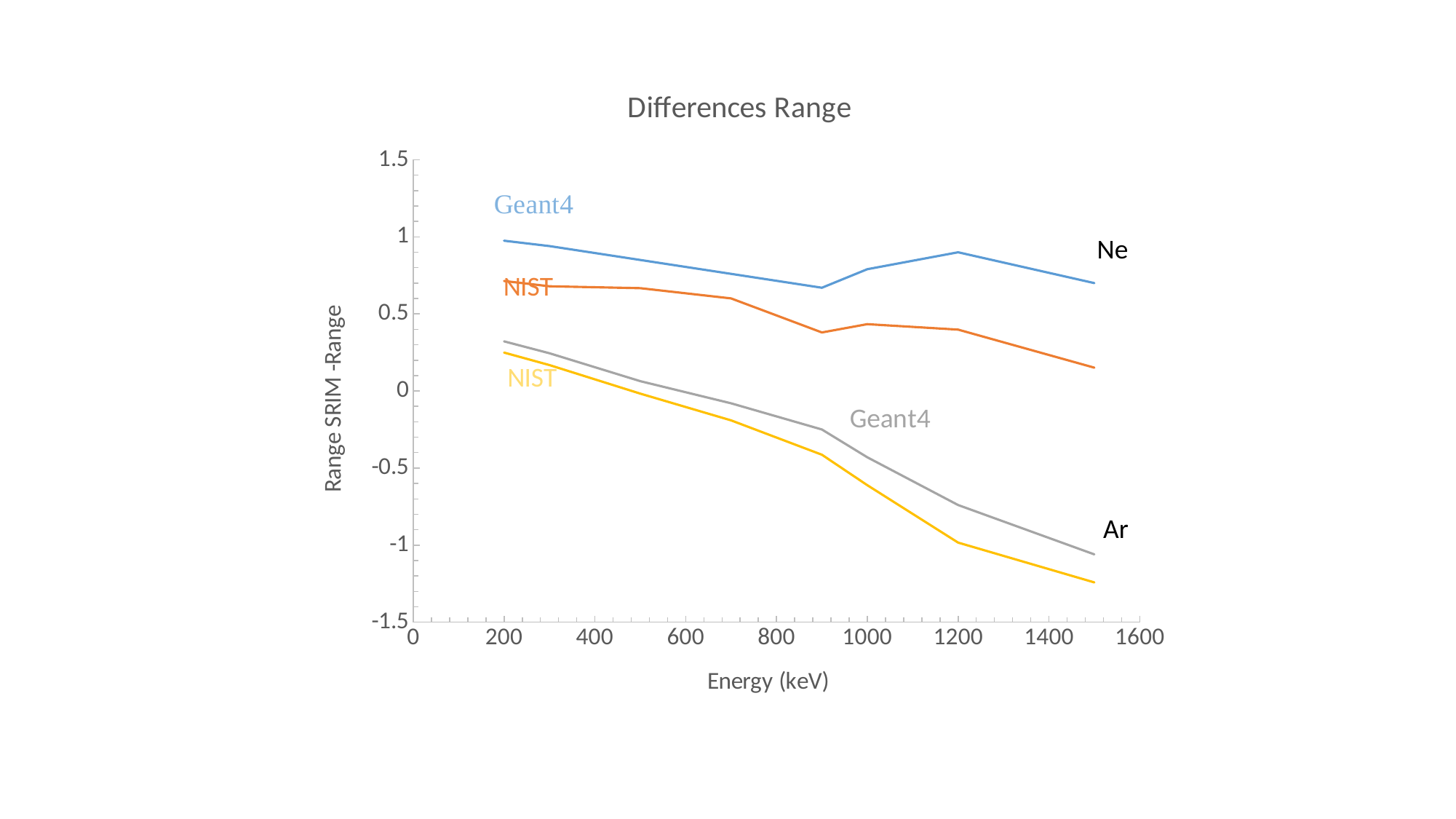
Which line has the highest value at 200 keV? Geant4 (Ne), the blue line Is the value of the blue Geant4 (Ne) line at 200 keV greater or less than 0.5? greater Which line has the lowest value at 1500 keV? NIST (Ar), the yellow line What is the label of the x axis? Energy (keV) Is the value of the orange NIST (Ne) line at 1500 keV greater or less than 0.5? less Does the yellow NIST (Ar) line rise or fall as energy increases? fall What is the title of the chart? Differences Range Is the value of the gray Geant4 (Ar) line at 1200 keV greater or less than -1? greater At 1500 keV, which is larger: the gray Geant4 (Ar) line or the yellow NIST (Ar) line? gray Geant4 (Ar) How many lines are plotted on the chart? 4 What kind of chart is shown on the slide? line chart